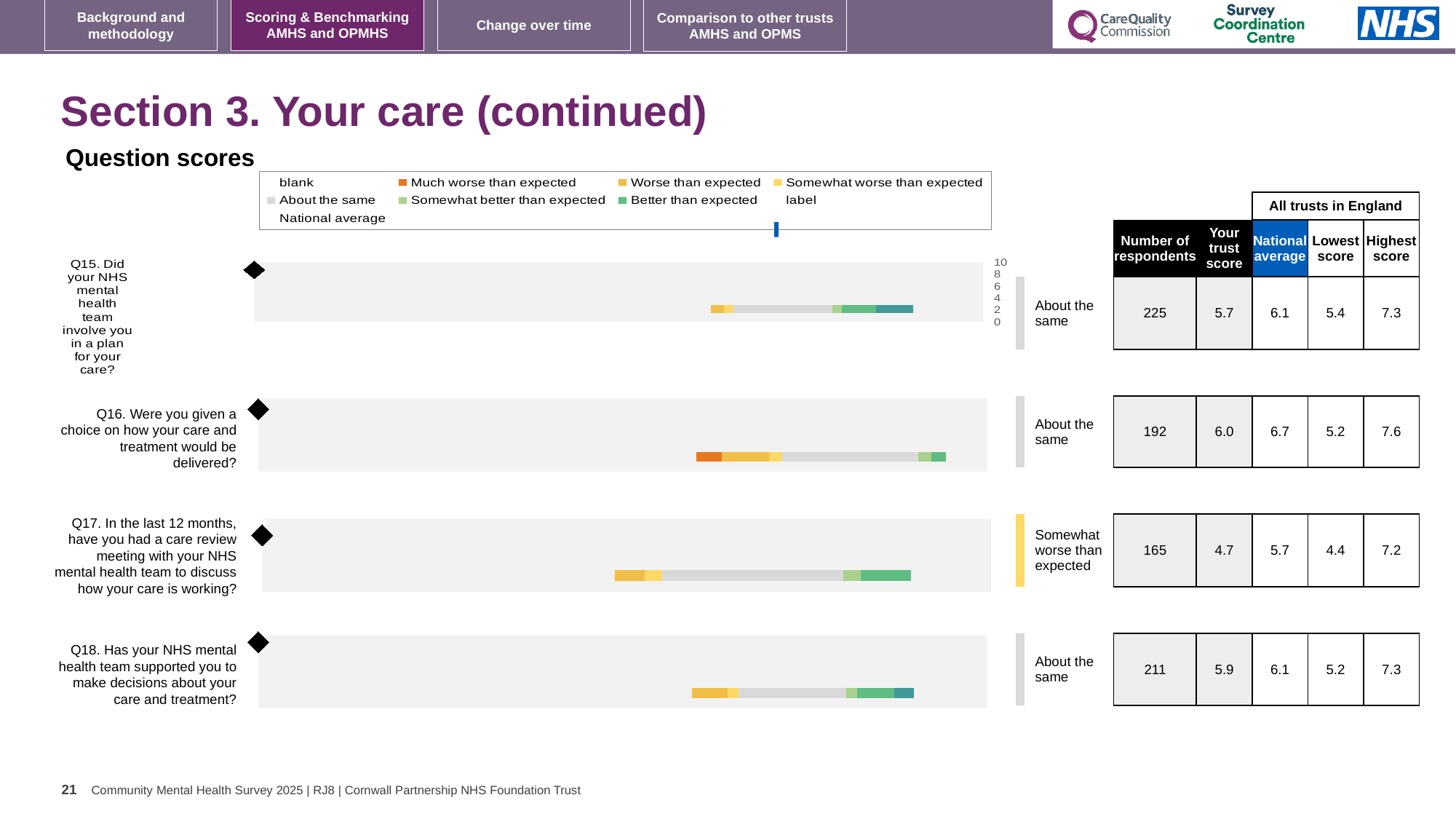
What is the 'Your trust score' value for Q16 (Were you given a choice on how your care and treatment would be delivered?)? 6.0 What is the lowest score among all trusts in England for Q18? 5.2 What is the national average for Q17 (care review meeting in the last 12 months)? 5.7 What kind of chart is used to show the question scores on this slide? bar chart How many questions (categories) are plotted in the question scores chart? 4 What is the highest score among all trusts in England for Q16? 7.6 What benchmark category label is shown for Q17? Somewhat worse than expected Which question has the highest 'Your trust score'? Q16 For Q18, which is larger: the trust score or the national average? National average For Q17, what is the difference between the national average and the trust score? 1.0 Which question has the lowest 'Your trust score'? Q17 How many respondents answered Q15 (Did your NHS mental health team involve you in a plan for your care?)? 225